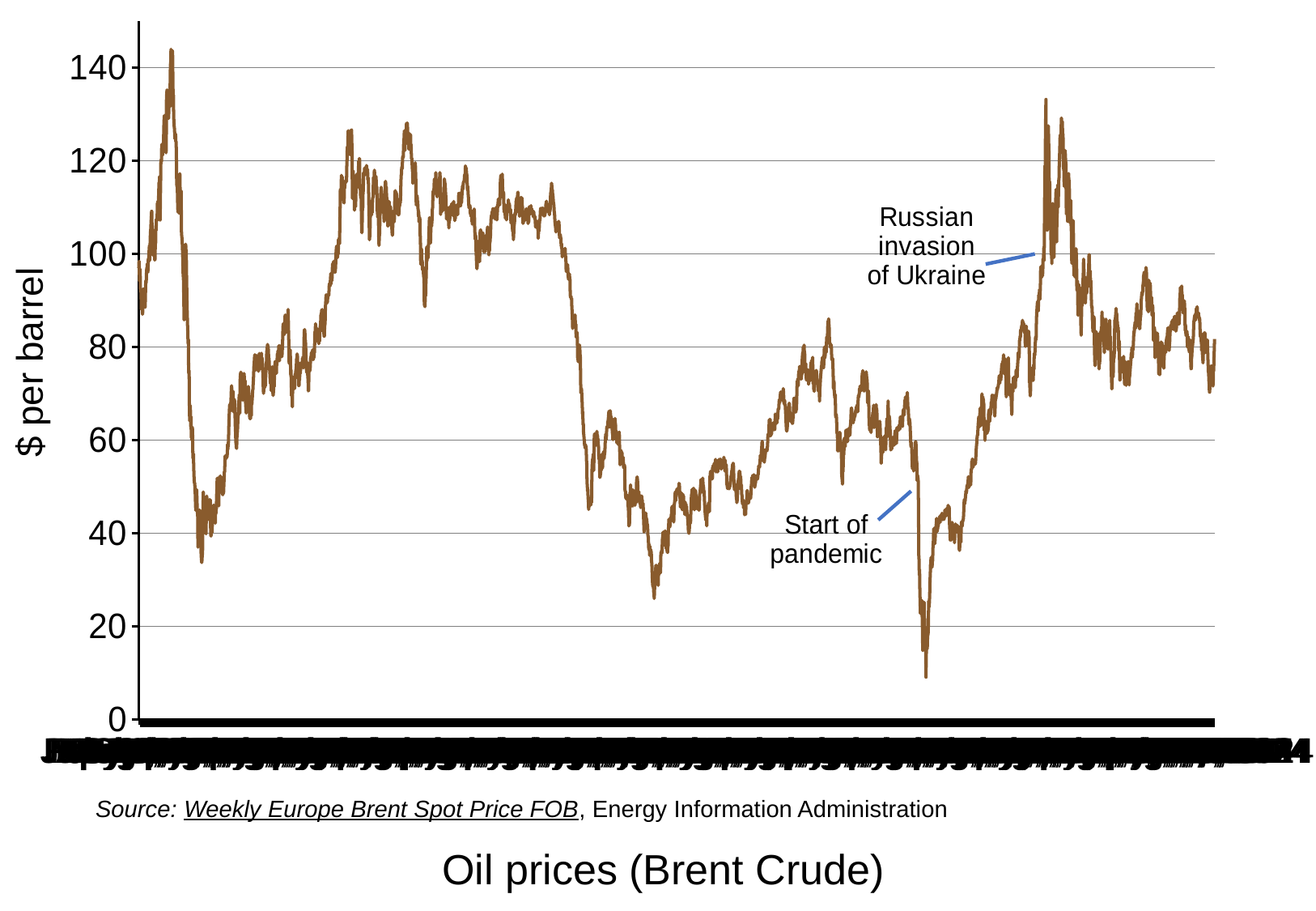
How many lines (series) are plotted on the chart? 1 What is the title of the chart? Oil prices (Brent Crude) Do oil prices rise or fall from the peak around the Russian invasion of Ukraine to the end of the chart? fall Is the peak value reached around the Russian invasion of Ukraine greater or less than 120? greater Is the highest value on the entire chart greater or less than 120? greater Is the lowest value on the chart, reached shortly after the start of the pandemic, greater or less than 20? less Which is higher: the peak around the Russian invasion of Ukraine or the lowest point after the start of the pandemic? the peak around the Russian invasion of Ukraine Do oil prices rise or fall in the period immediately after the start of the pandemic annotation? fall What is the label on the vertical axis of the chart? $ per barrel What kind of chart is shown on the slide? line chart